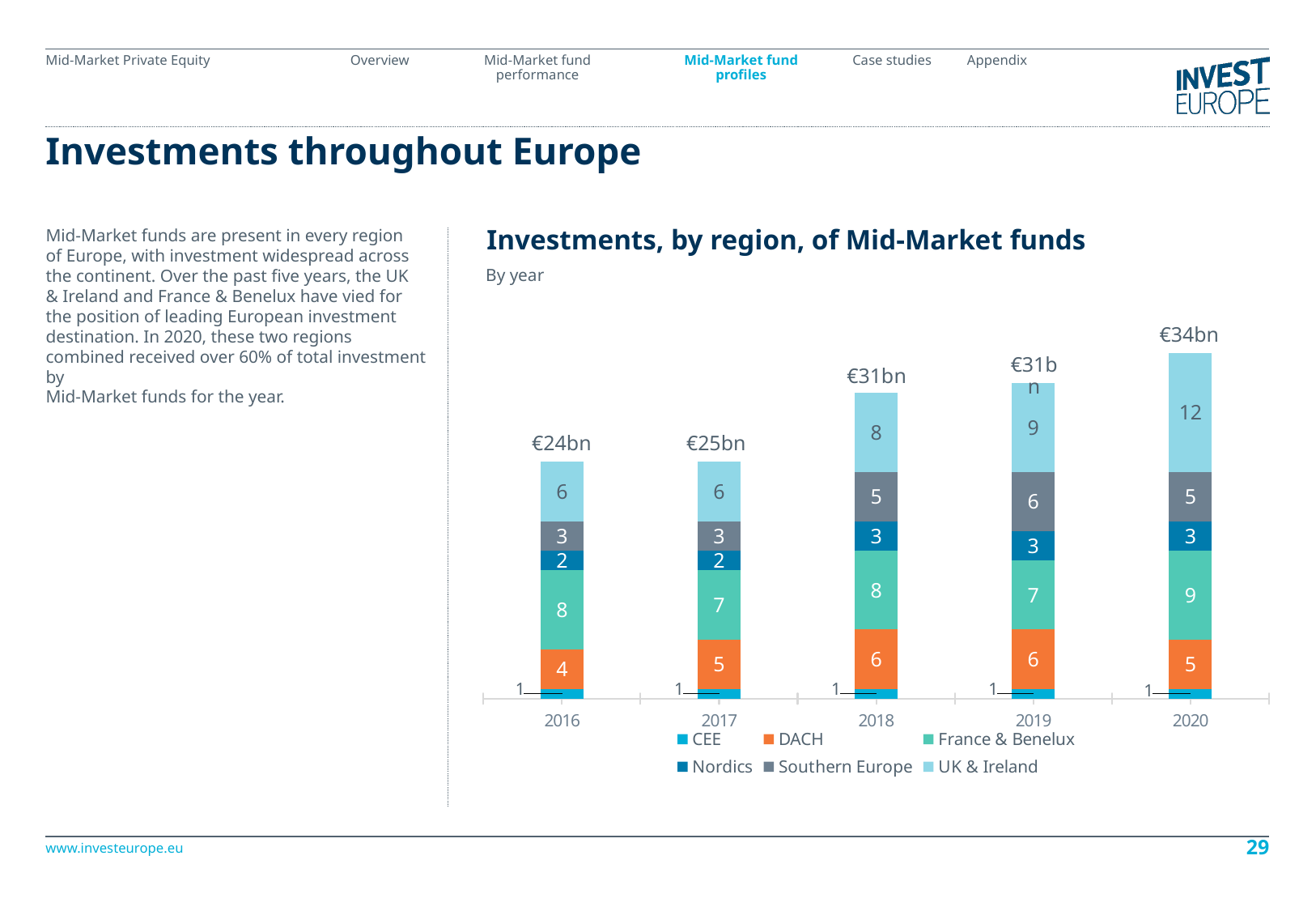
In 2019, which is larger: the value for UK & Ireland or the value for France & Benelux? UK & Ireland What is the value for DACH in 2016? 4 What is the difference between the UK & Ireland value in 2020 and in 2016? 6 What is the total investment shown for 2016? €24bn What type of chart is shown on the slide? Stacked bar chart How many years are shown on the x axis? 5 What is the value for France & Benelux in 2018? 8 What is the total investment shown for 2020? €34bn What is the value for UK & Ireland in 2020? 12 How many series does the legend list? 6 Which year has the lowest total investment? 2016 Which year has the highest total investment? 2020